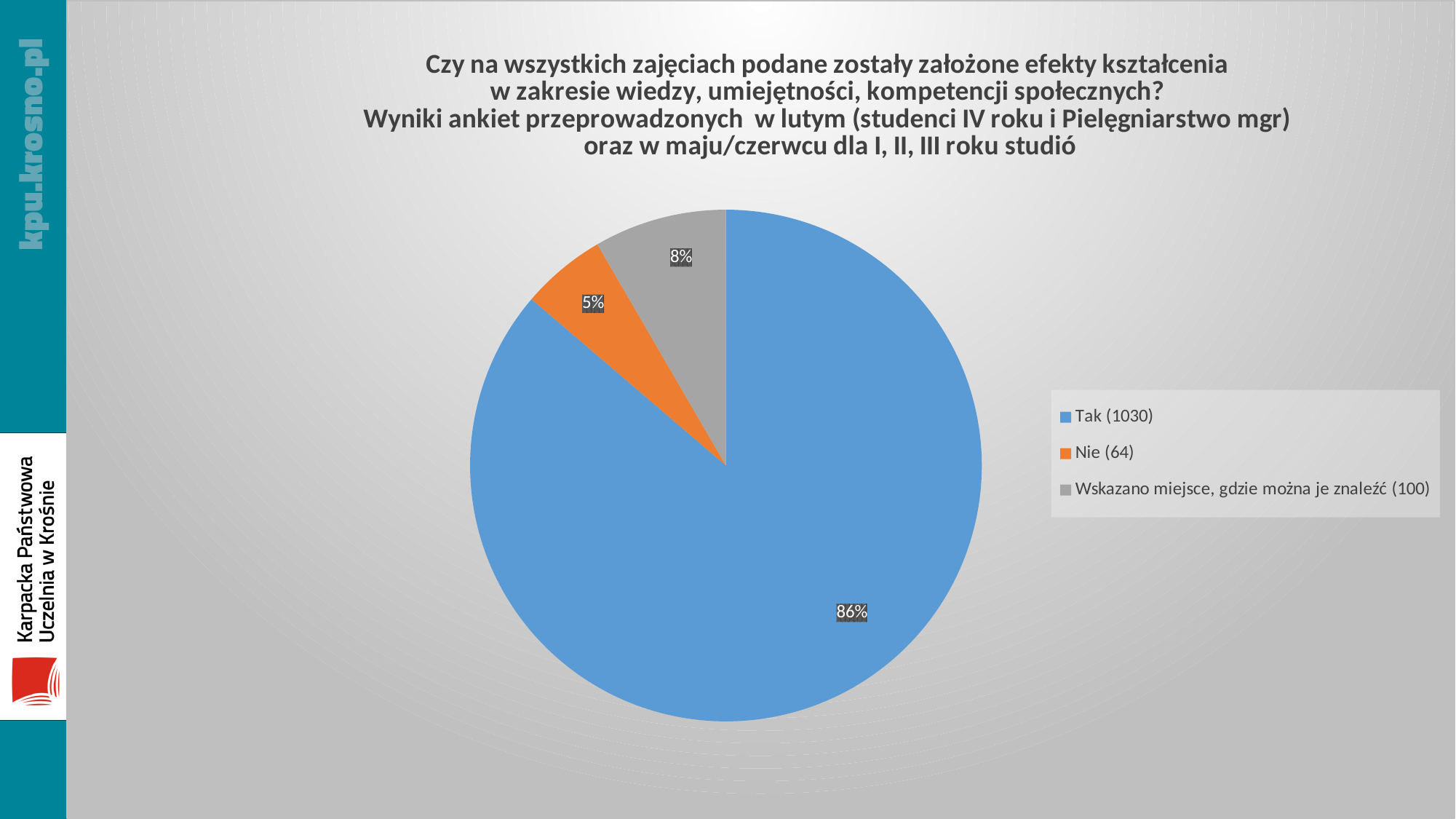
What percentage share does the 'Nie (64)' slice have? 5% What type of chart is shown on the slide? Pie chart What is the difference in percentage points between the 'Tak (1030)' slice and the 'Wskazano miejsce, gdzie można je znaleźć (100)' slice? 78 percentage points What colour is the 'Nie (64)' slice? Orange What percentage share does the 'Tak (1030)' slice have? 86% Which category has the smallest slice of the pie? Nie (64) How many entries does the legend list? 3 What percentage share does the 'Wskazano miejsce, gdzie można je znaleźć (100)' slice have? 8% Which category has the largest slice of the pie? Tak (1030) Which slice is larger: 'Nie (64)' or 'Wskazano miejsce, gdzie można je znaleźć (100)'? Wskazano miejsce, gdzie można je znaleźć (100) What is the difference in percentage points between the 'Wskazano miejsce, gdzie można je znaleźć (100)' slice and the 'Nie (64)' slice? 3 percentage points How many slices does the pie chart have? 3